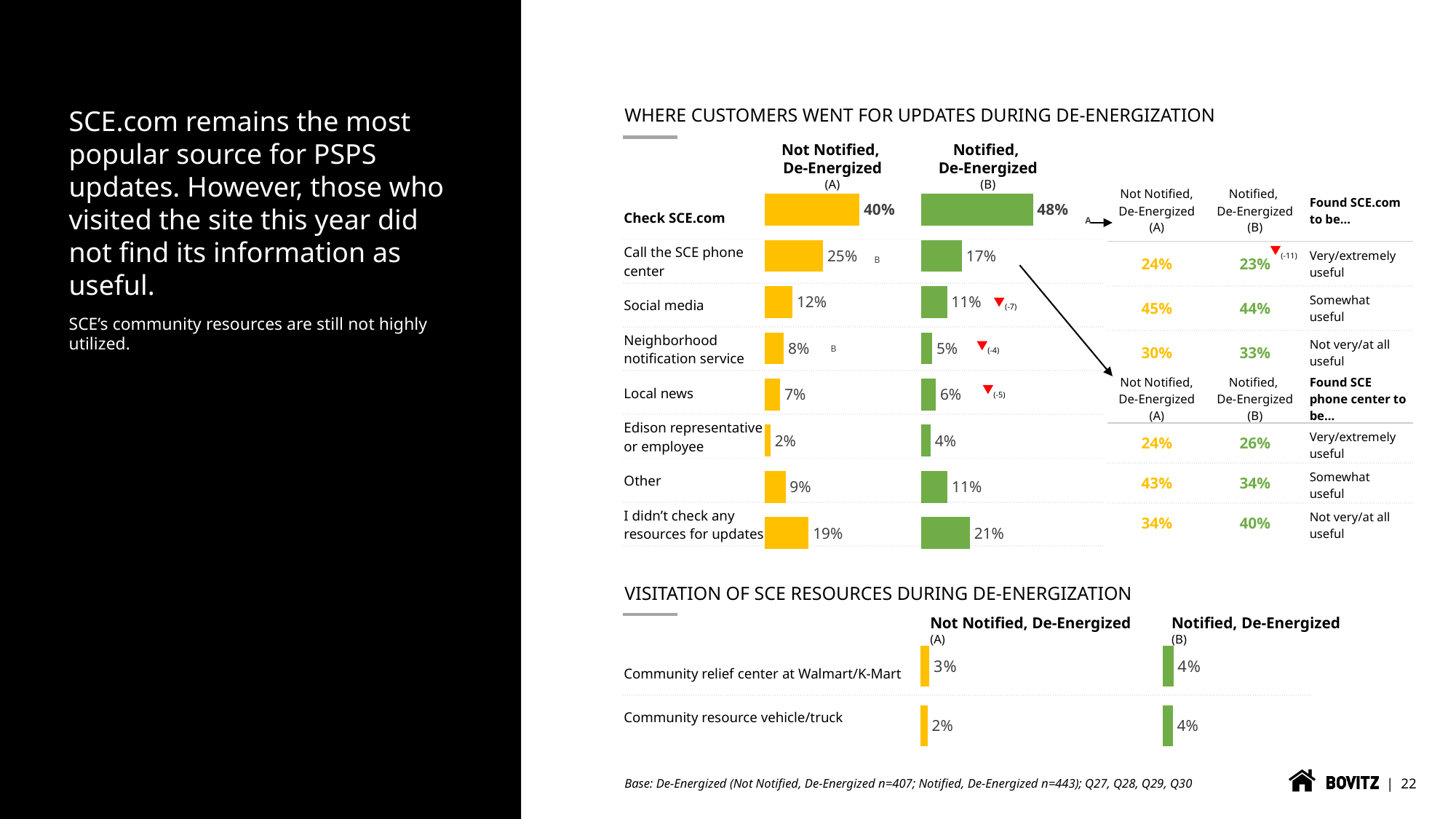
In the 'Where customers went for updates during de-energization' chart, what percentage of Notified, De-Energized customers called the SCE phone center? 17% In the 'Where customers went for updates during de-energization' chart, what percentage of Not Notified, De-Energized customers checked SCE.com? 40% In the 'Where customers went for updates during de-energization' chart, which source has the highest value for Notified, De-Energized customers? Check SCE.com In the 'Where customers went for updates during de-energization' chart, which group has the larger value for Social media: Not Notified, De-Energized or Notified, De-Energized? Not Notified, De-Energized In the 'Where customers went for updates during de-energization' chart, which source has the lowest value for Not Notified, De-Energized customers? Edison representative or employee In the 'Visitation of SCE resources during de-energization' chart, what percentage of Notified, De-Energized customers visited a community resource vehicle/truck? 4% How many sources are listed in the 'Where customers went for updates during de-energization' chart? 8 How many resources are listed in the 'Visitation of SCE resources during de-energization' chart? 2 In the 'Where customers went for updates during de-energization' chart, what is the difference between the Notified and Not Notified values for Check SCE.com? 8% What type of chart is used in the 'Where customers went for updates during de-energization' section? Bar chart In the 'Visitation of SCE resources during de-energization' chart, what percentage of Not Notified, De-Energized customers visited the community relief center at Walmart/K-Mart? 3% In the 'Where customers went for updates during de-energization' chart, what colour are the bars for the Notified, De-Energized group? Green